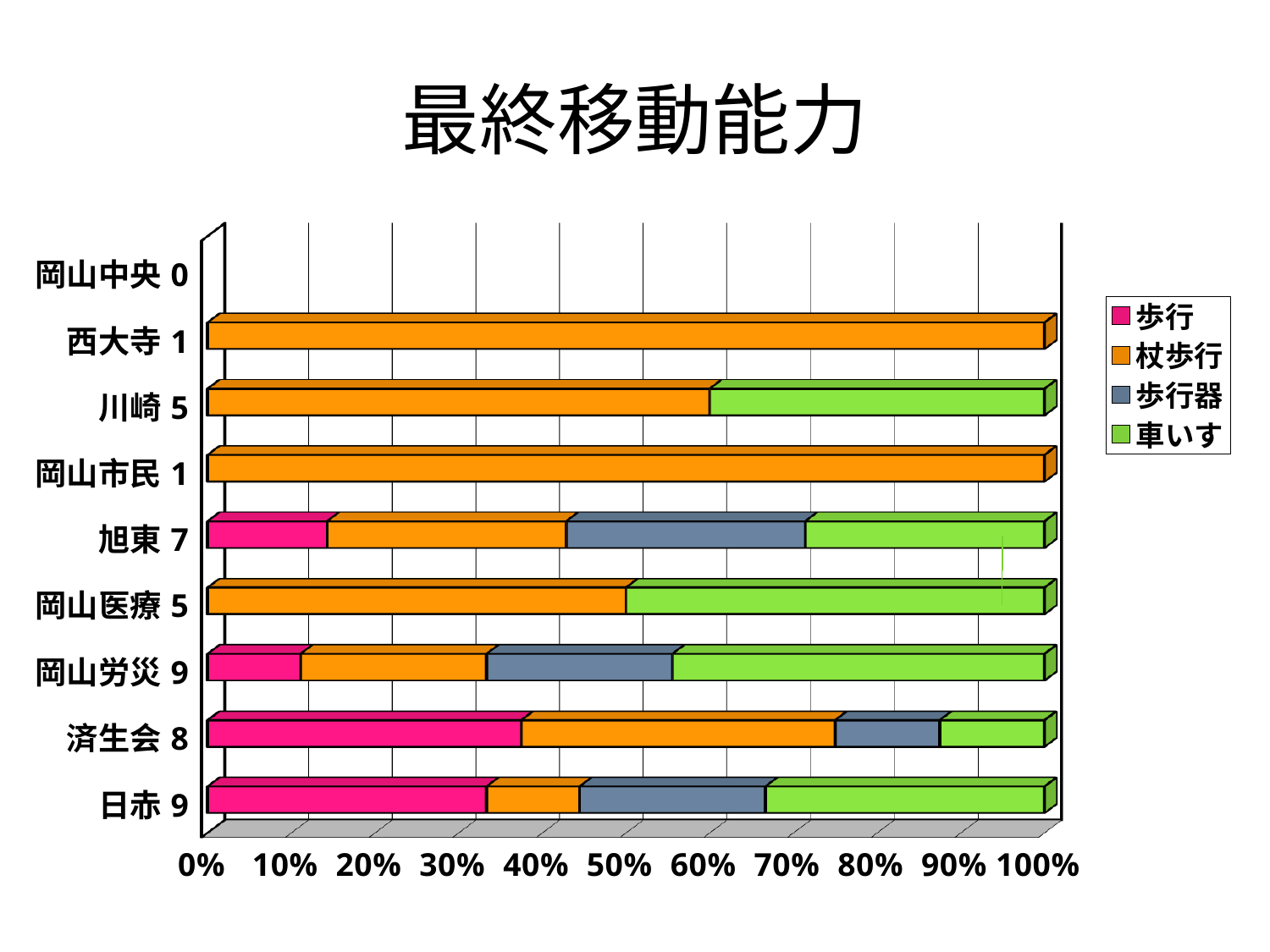
What is the title of the chart? 最終移動能力 How many series does the legend list? 4 Is the 車いす share for 岡山労災 9 greater or less than 30%? greater What share of 西大寺 1 is 杖歩行? 100% Which legend entry is shown in green? 車いす What share of 岡山市民 1 is 杖歩行? 100% What kind of chart is shown on the slide? Stacked bar chart Which has the larger 歩行 share, 済生会 8 or 旭東 7? 済生会 8 Is the 歩行 share for 済生会 8 greater or less than 30%? greater How many categories are shown on the vertical axis? 9 Is the 歩行 share for 旭東 7 greater or less than 20%? less Which category has the largest 車いす share? 岡山医療 5